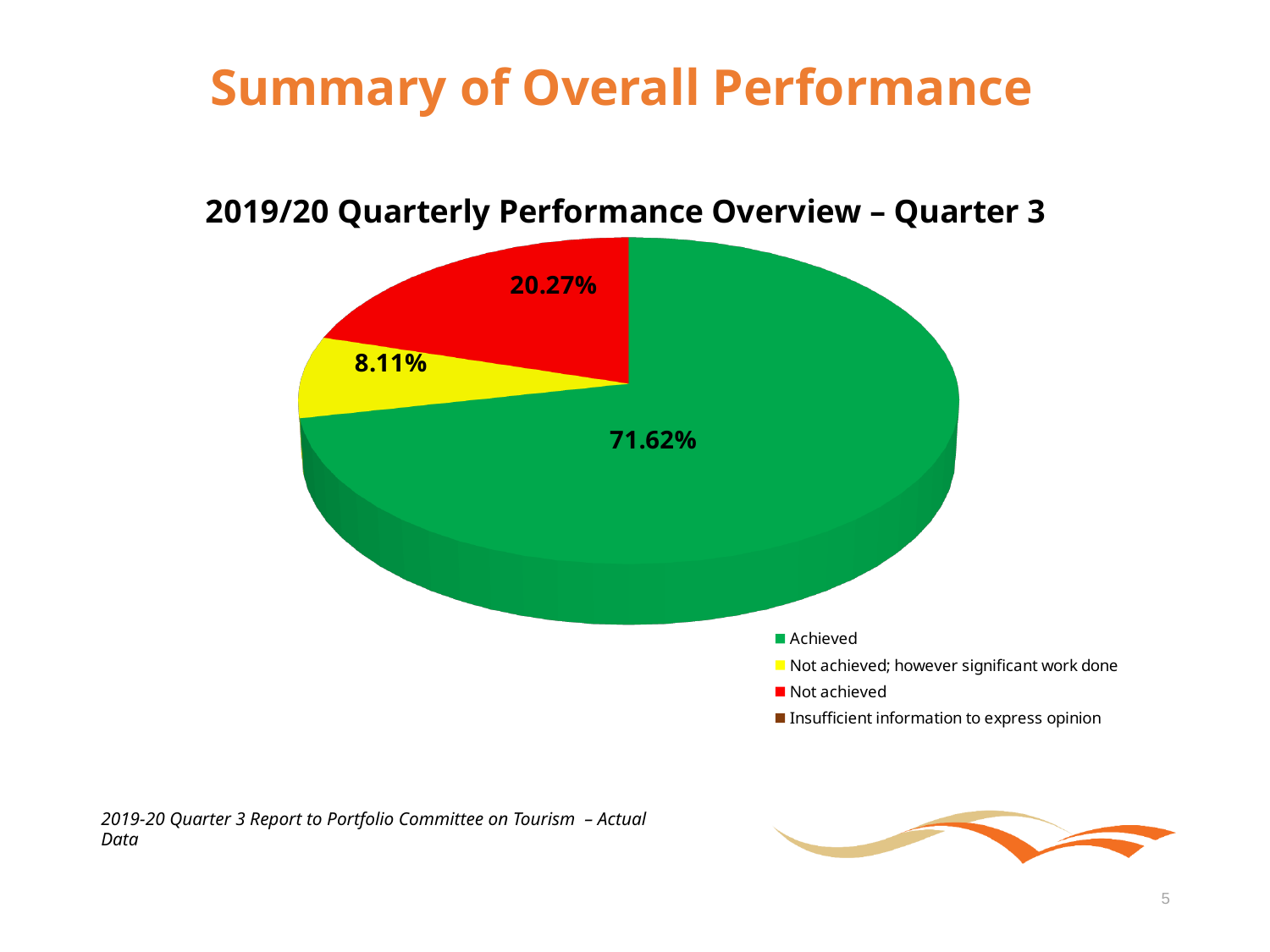
How many entries does the legend list? 4 What is the value for Not achieved? 20.27% What is the difference between the Not achieved share and the Not achieved; however significant work done share? 12.16% Which is larger, the Not achieved slice or the Not achieved; however significant work done slice? Not achieved What is the value for Not achieved; however significant work done? 8.11% Which labelled slice has the smallest share of the pie? Not achieved; however significant work done What is the value for Achieved? 71.62% Which category has the largest share of the pie? Achieved What colour is the Achieved slice? Green What is the difference between the Achieved share and the Not achieved share? 51.35% What kind of chart is shown on the slide? Pie chart What is the title of the chart? 2019/20 Quarterly Performance Overview – Quarter 3